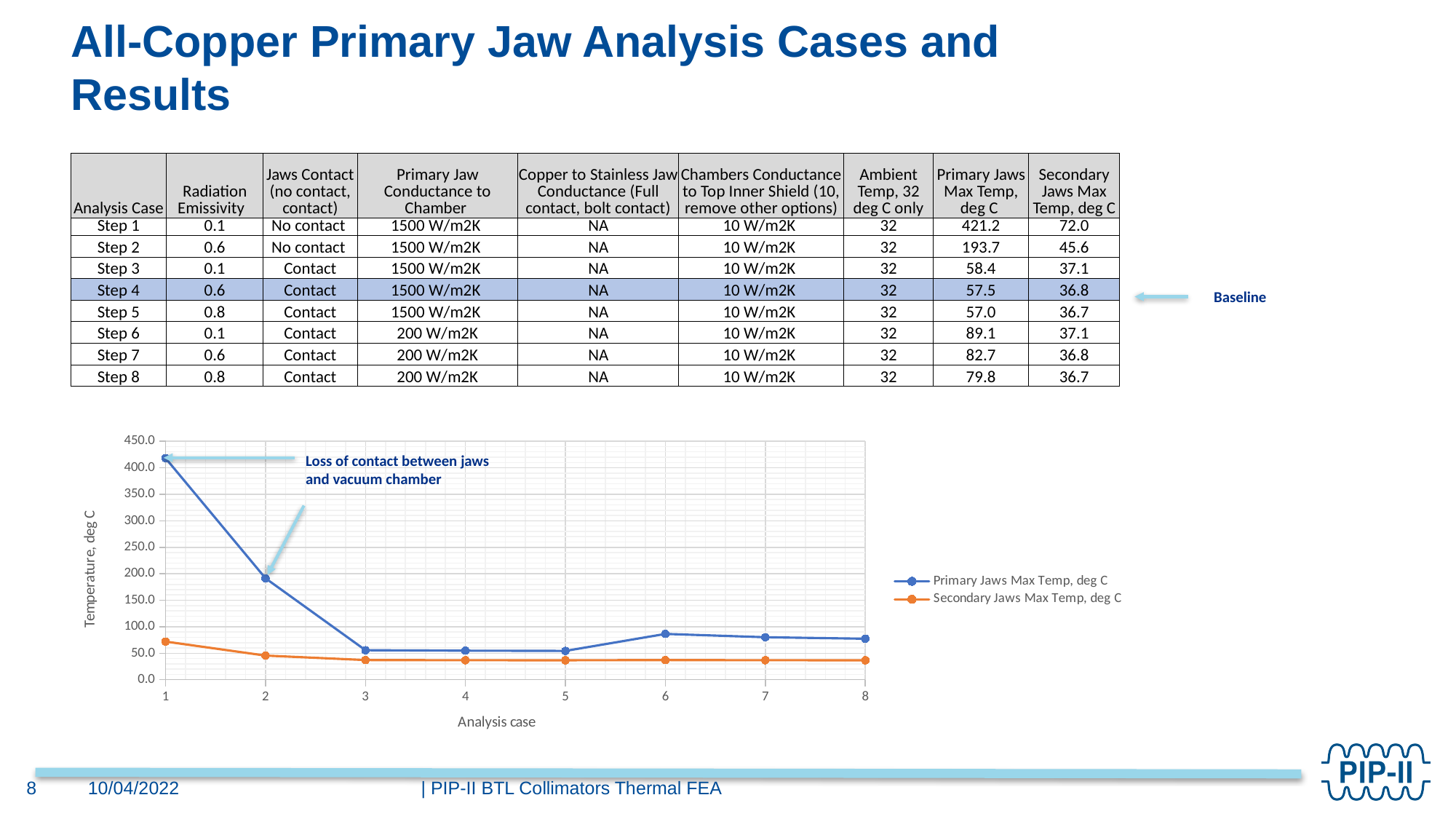
How many analysis cases are plotted along the x axis of the chart? 8 What is the Secondary Jaws Max Temp for analysis case 2? 45.6 What is the difference between the Primary Jaws Max Temp at analysis case 1 and at analysis case 2? 227.5 What is the Primary Jaws Max Temp for analysis case 1? 421.2 What kind of chart is shown on the slide? Line chart How many series does the chart legend list? 2 Which analysis case has the lowest Primary Jaws Max Temp? 5 Which is larger at analysis case 6: the Primary Jaws Max Temp or the Secondary Jaws Max Temp? Primary Jaws Max Temp What is the label of the chart's y axis? Temperature, deg C Is the Primary Jaws Max Temp for analysis case 2 greater or less than 150.0? greater Which analysis case has the highest Primary Jaws Max Temp? 1 Is the Secondary Jaws Max Temp for analysis case 1 greater or less than 100.0? less